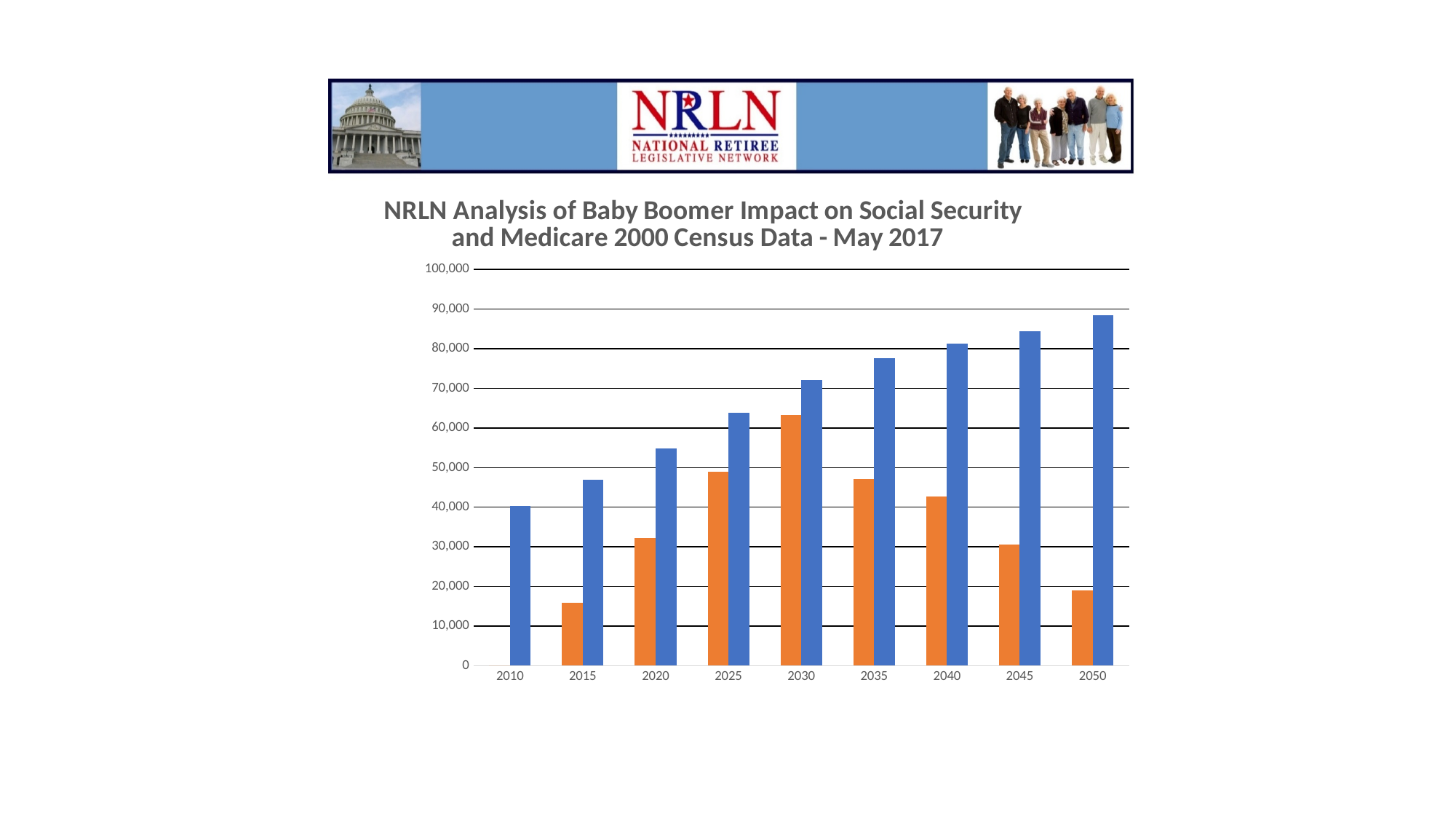
Is the orange bar for 2030 greater or less than 60,000? greater Which is larger in 2040, the blue bar or the orange bar? The blue bar How many years are shown along the x axis of the chart? 9 What is the title of the chart? NRLN Analysis of Baby Boomer Impact on Social Security and Medicare 2000 Census Data - May 2017 In which year is the orange bar highest? 2030 What kind of chart is shown on the slide? Bar chart In which year is the blue bar lowest? 2010 Is the blue bar for 2050 greater or less than 80,000? greater Do the blue bars rise or fall from 2010 to 2050? Rise In which year is the blue bar highest? 2050 Among the years that have an orange bar, in which year is the orange bar lowest? 2015 Is the orange bar for 2015 greater or less than 20,000? less